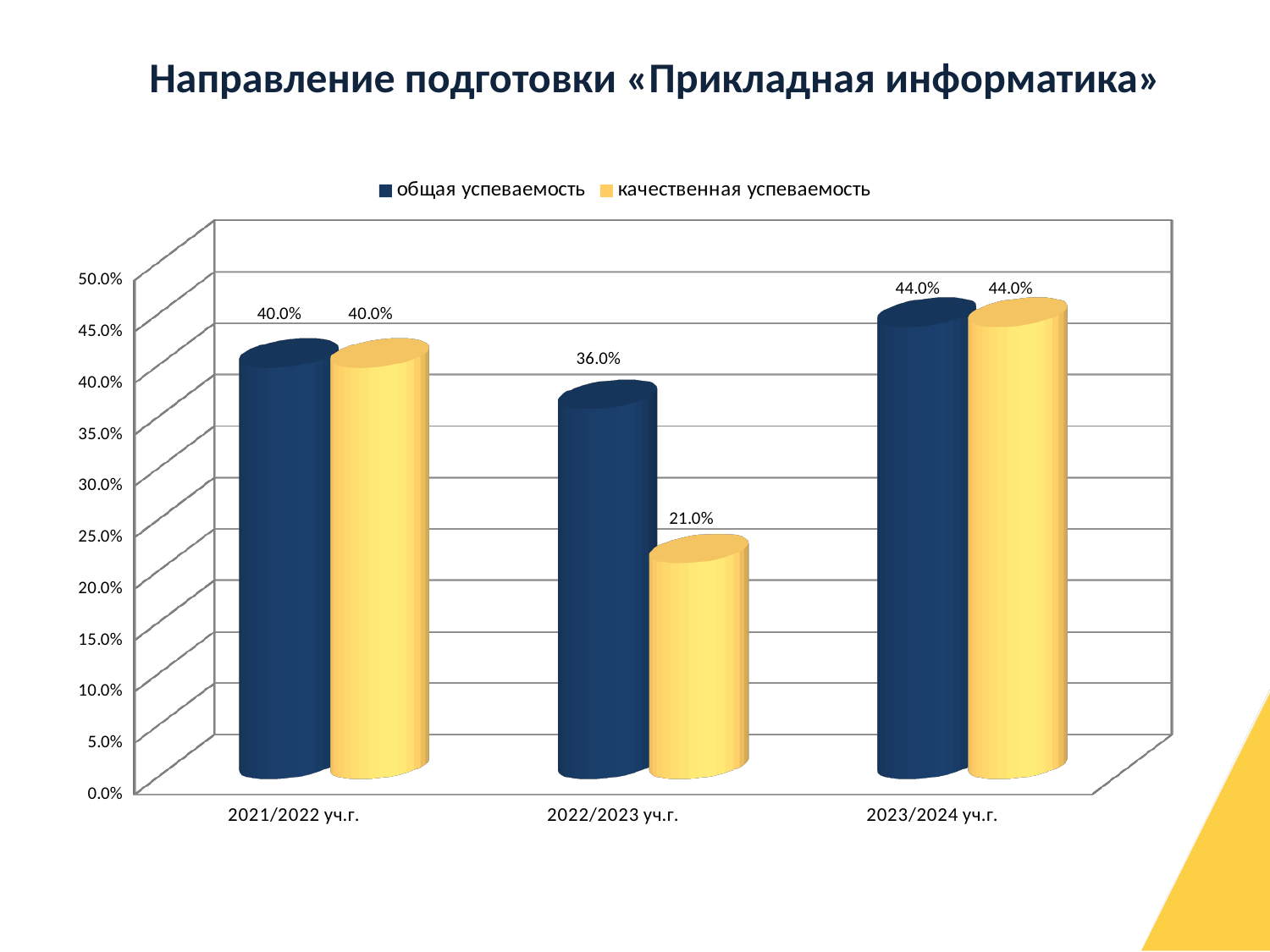
In which academic year is общая успеваемость the highest? 2023/2024 уч.г. In which academic year is качественная успеваемость the lowest? 2022/2023 уч.г. What is the difference between общая успеваемость and качественная успеваемость in 2022/2023 уч.г.? 15.0% What is the title of the slide? Направление подготовки «Прикладная информатика» What is the value of общая успеваемость for 2022/2023 уч.г.? 36.0% How many series does the legend list? 2 Which is larger: общая успеваемость in 2021/2022 уч.г. or общая успеваемость in 2023/2024 уч.г.? 2023/2024 уч.г. What kind of chart is shown on the slide? bar chart What is the value of общая успеваемость for 2021/2022 уч.г.? 40.0% What is the value of качественная успеваемость for 2022/2023 уч.г.? 21.0% What is the value of качественная успеваемость for 2023/2024 уч.г.? 44.0% How many academic years are shown on the x axis? 3